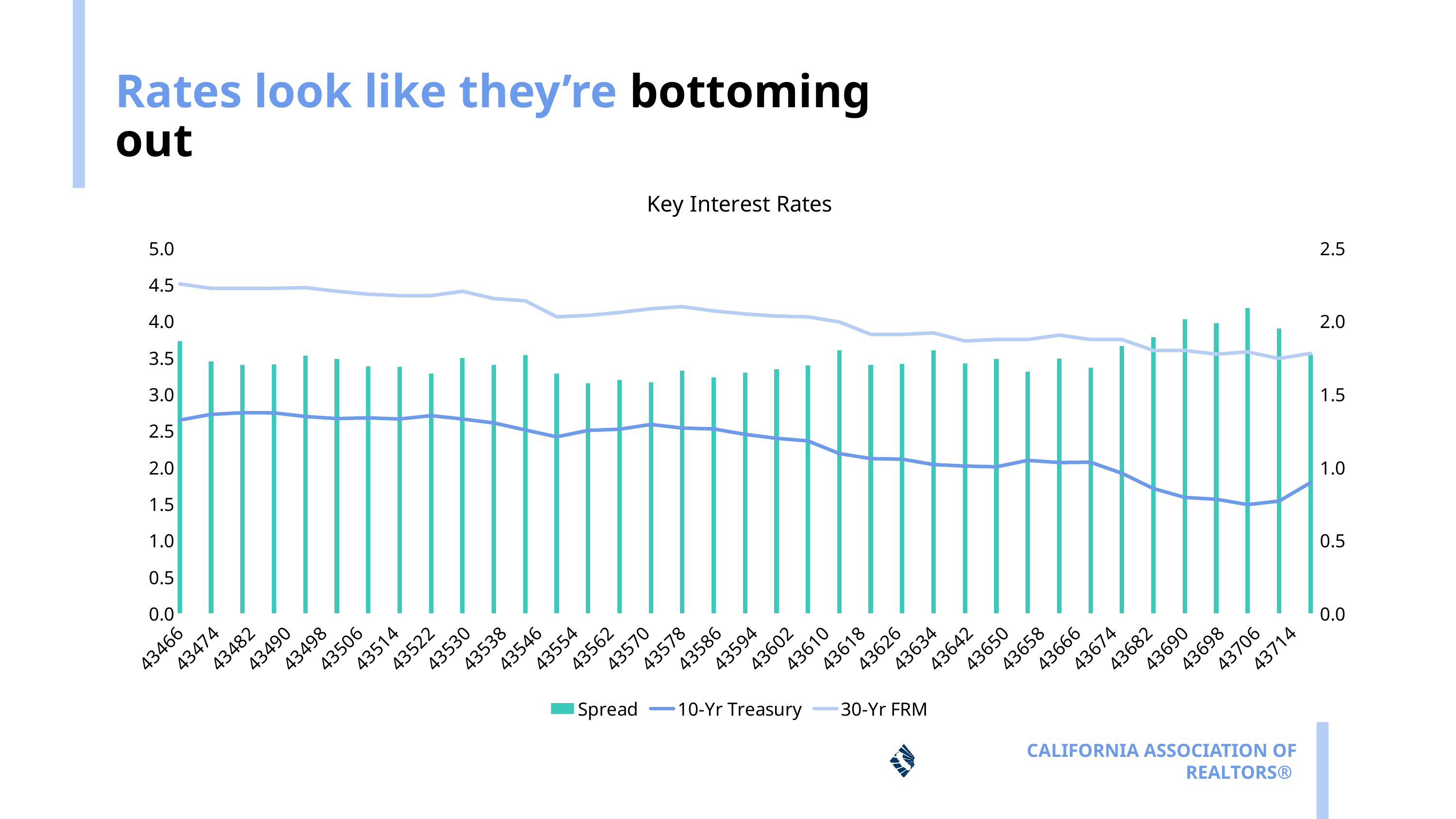
What is the title of the chart? Key Interest Rates Is the Spread value at 43706 greater or less than 2.0 on the right axis? greater Which is larger at 43466, the 30-Yr FRM or the 10-Yr Treasury? 30-Yr FRM Is the 10-Yr Treasury value at 43466 greater or less than 2.5? greater Is the 10-Yr Treasury value at 43706 greater or less than 2.0? less How many series does the chart legend list? 3 What kind of chart is shown on the slide? Combined bar and line chart At which x-axis label is the Spread bar the tallest? 43706 Does the 10-Yr Treasury line generally rise or fall from left to right across the chart? fall Which series is plotted as bars in the chart? Spread